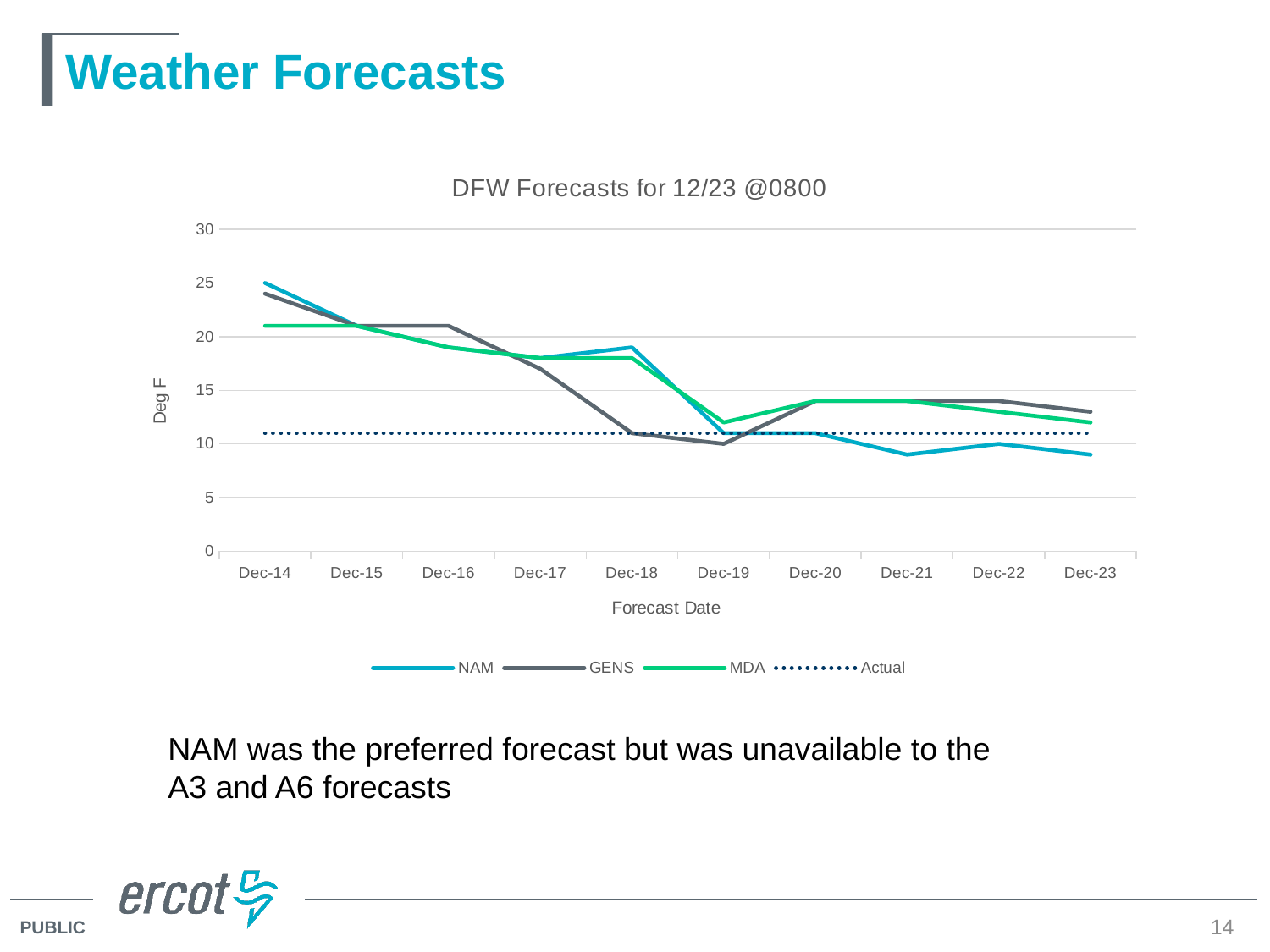
Which series is drawn as a dotted line? Actual What is the title of the chart? DFW Forecasts for 12/23 @0800 Is the MDA value on Dec-14 greater or less than 20? greater What is the NAM value on Dec-14? 25 Which series has the lowest value on Dec-23? NAM How many forecast dates are shown on the x axis? 10 Is the NAM value on Dec-21 greater or less than 10? less Which series has the highest value on Dec-14? NAM What type of chart is shown on the slide? Line chart On Dec-18, which is larger, the NAM value or the GENS value? NAM How many series does the legend list? 4 Is the GENS value on Dec-21 greater or less than 10? greater